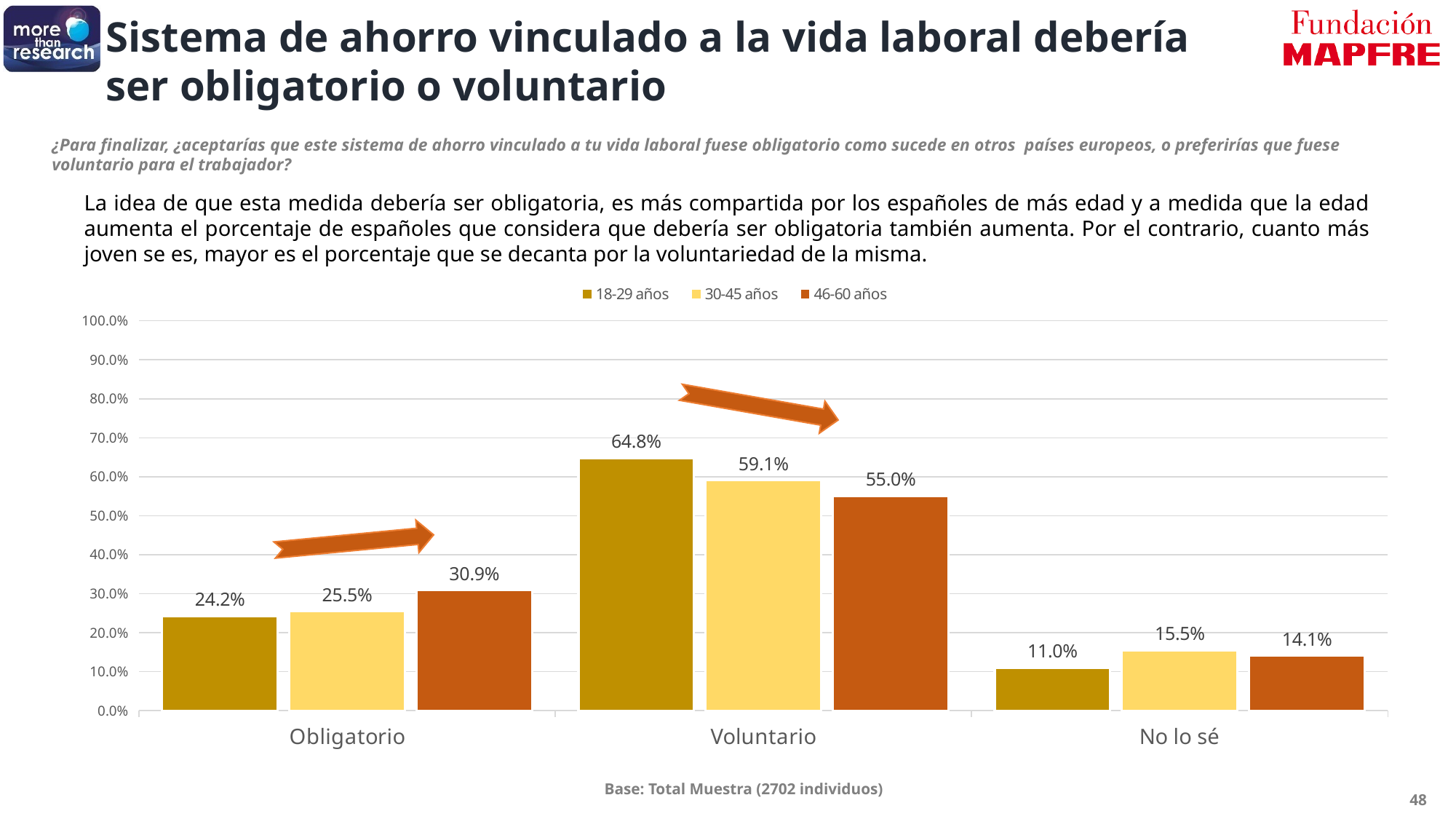
Is the value for 30-45 años in the Voluntario category greater or less than 50.0%? greater How many categories are shown on the x axis? 3 Which age group has the lowest value in the No lo sé category? 18-29 años Which age group has the highest value in the Voluntario category? 18-29 años What is the value for the 30-45 años series in the No lo sé category? 15.5% What is the difference between the 18-29 años and 46-60 años values in the Voluntario category? 9.8% What kind of chart is shown on the slide? bar chart What is the value for the 18-29 años series in the Voluntario category? 64.8% What is the base (sample size) stated below the chart? Total Muestra (2702 individuos) What is the value for the 46-60 años series in the Obligatorio category? 30.9% How many series does the legend list? 3 Which is larger: the 30-45 años value for Obligatorio or the 46-60 años value for Obligatorio? 46-60 años